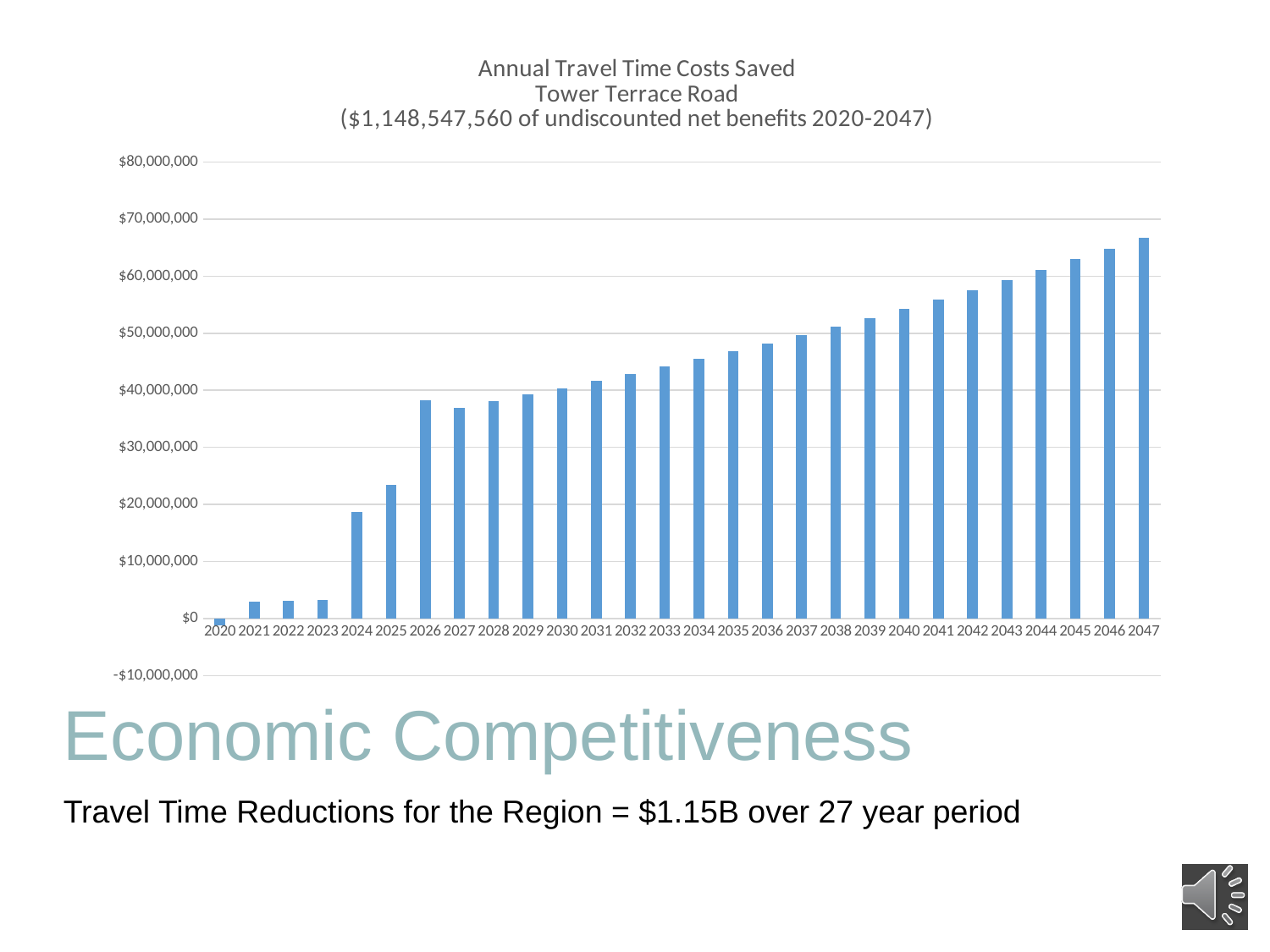
What kind of chart is shown on the slide? bar chart Is the value for 2021 greater or less than $10,000,000? less Is the value for 2025 greater or less than $20,000,000? greater Is the value for 2024 greater or less than $20,000,000? less Which year has the highest annual travel time costs saved? 2047 Which year has the larger value, 2024 or 2025? 2025 Do the values generally rise or fall from 2020 to 2047? rise According to the chart title, what is the total of undiscounted net benefits for 2020-2047? $1,148,547,560 Which year has the lowest value in the chart? 2020 How many years are plotted on the x axis of the chart? 28